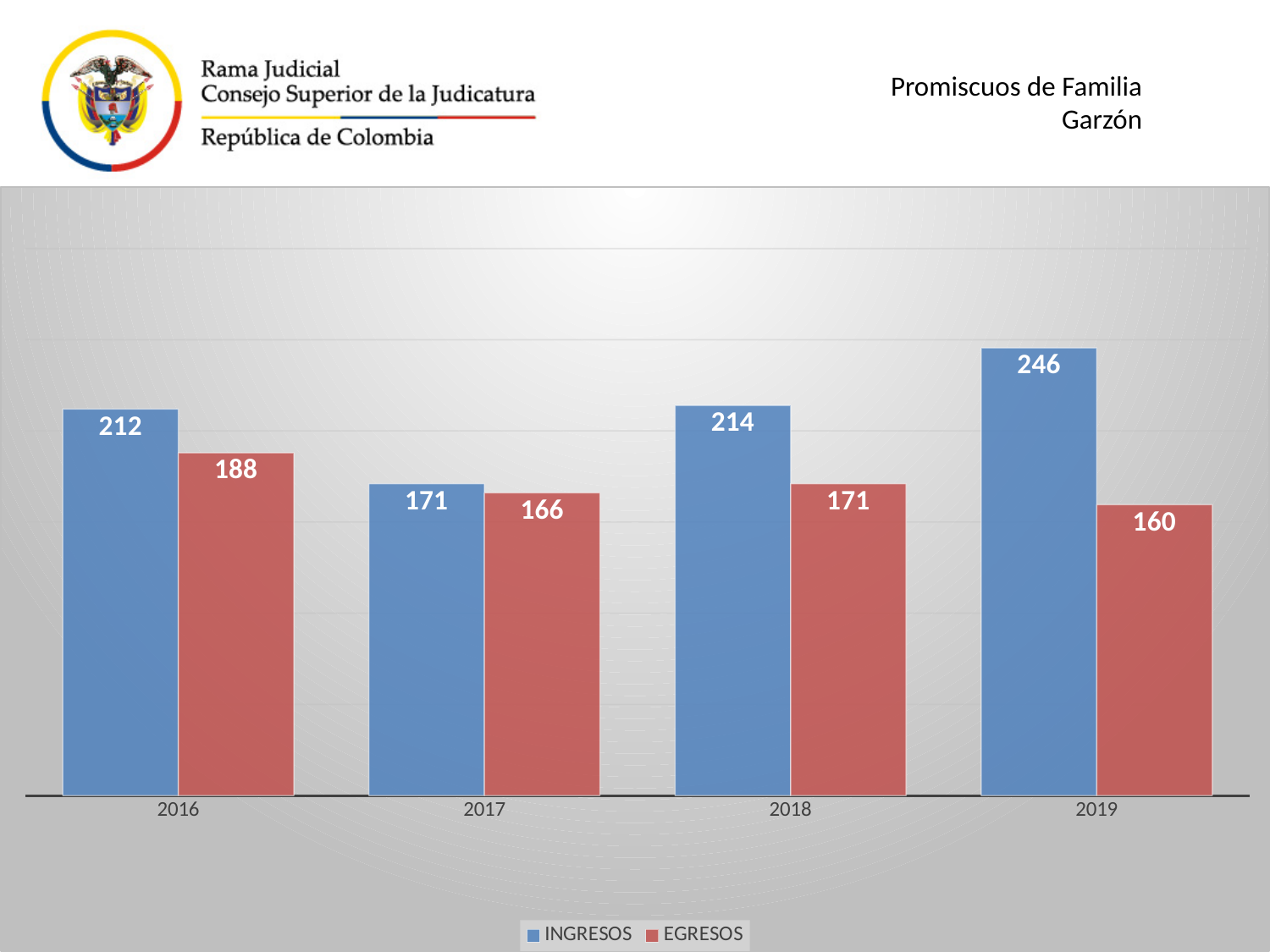
How many series does the legend list? 2 What is the INGRESOS value for 2016? 212 Which is larger, EGRESOS in 2016 or EGRESOS in 2018? EGRESOS in 2016 What is the EGRESOS value for 2017? 166 How many years are shown on the x axis? 4 Which year has the highest INGRESOS value? 2019 Which year has the lowest EGRESOS value? 2019 What is the difference between INGRESOS and EGRESOS in 2019? 86 Which colour represents EGRESOS in the chart? Red What kind of chart is shown on the slide? Bar chart What is the difference between INGRESOS in 2018 and INGRESOS in 2017? 43 What is the EGRESOS value for 2019? 160